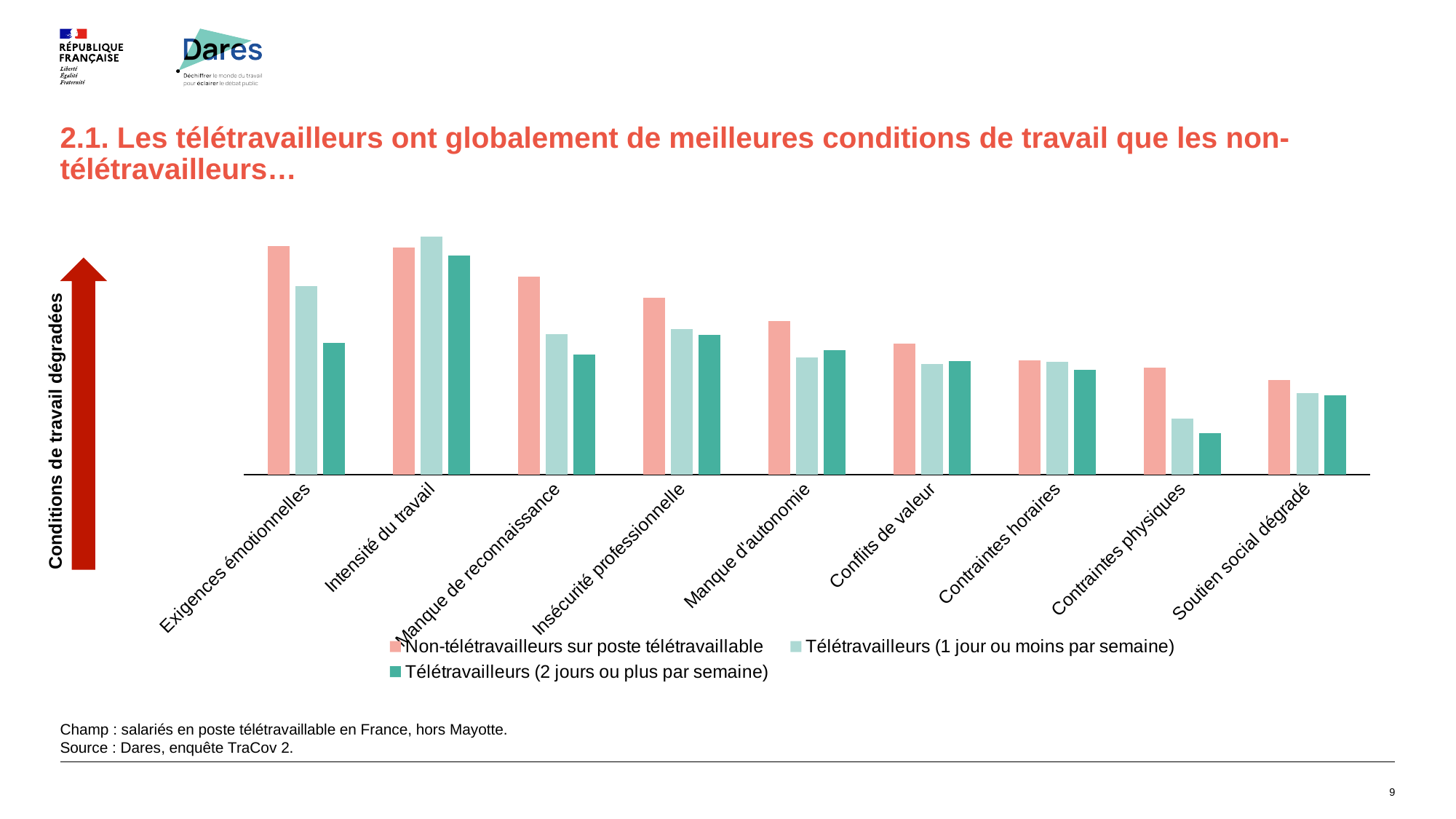
For the series 'Télétravailleurs (2 jours ou plus par semaine)', which category has the highest bar? Intensité du travail What kind of chart is shown on the slide? Bar chart Which legend entry is shown in the darkest green colour? Télétravailleurs (2 jours ou plus par semaine) How many categories are shown along the x axis of the chart? 9 For the series 'Télétravailleurs (2 jours ou plus par semaine)', which category has the lowest bar? Contraintes physiques For the series 'Télétravailleurs (1 jour ou moins par semaine)', which category has the highest bar? Intensité du travail For 'Contraintes physiques', which is larger: the bar for 'Télétravailleurs (1 jour ou moins par semaine)' or the bar for 'Télétravailleurs (2 jours ou plus par semaine)'? Télétravailleurs (1 jour ou moins par semaine) For 'Exigences émotionnelles', which is larger: the bar for 'Non-télétravailleurs sur poste télétravaillable' or the bar for 'Télétravailleurs (2 jours ou plus par semaine)'? Non-télétravailleurs sur poste télétravaillable How many series does the chart's legend list? 3 What is the label on the vertical axis of the chart? Conditions de travail dégradées Do the bars for 'Non-télétravailleurs sur poste télétravaillable' rise or fall from left to right along the x axis? Fall For the series 'Télétravailleurs (1 jour ou moins par semaine)', which category has the lowest bar? Contraintes physiques